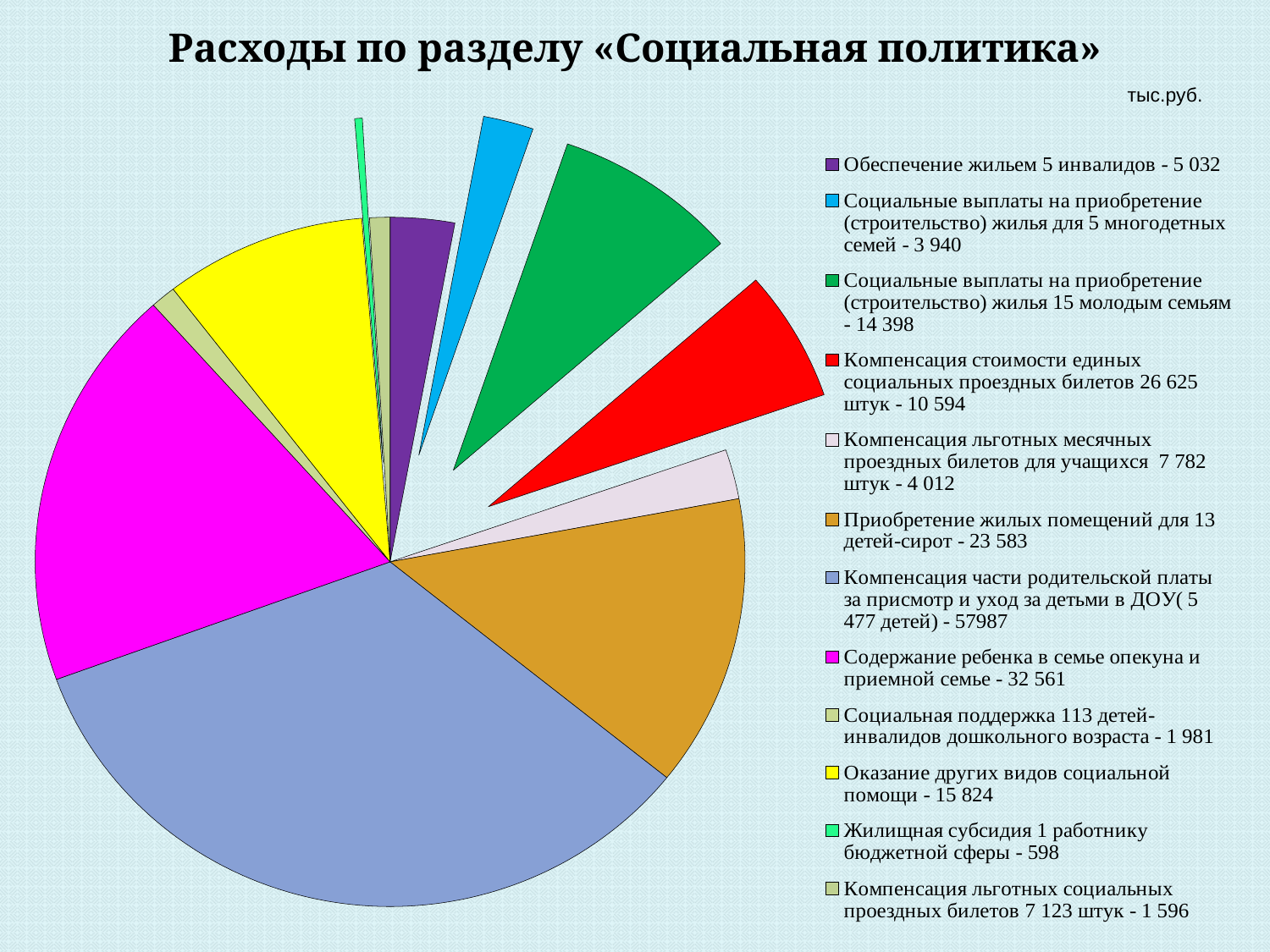
Which category has the smallest value? Жилищная субсидия 1 работнику бюджетной сферы What is the value for «Оказание других видов социальной помощи»? 15 824 What is the value for «Обеспечение жильем 5 инвалидов»? 5 032 Which is larger: «Социальные выплаты на приобретение (строительство) жилья 15 молодым семьям» or «Компенсация стоимости единых социальных проездных билетов 26 625 штук»? Социальные выплаты на приобретение (строительство) жилья 15 молодым семьям In what units are the values on the chart given? тыс.руб. How many categories does the pie chart have? 12 What is the value for «Приобретение жилых помещений для 13 детей-сирот»? 23 583 What is the difference between «Содержание ребенка в семье опекуна и приемной семье» and «Приобретение жилых помещений для 13 детей-сирот»? 8 978 Which category has the largest value? Компенсация части родительской платы за присмотр и уход за детьми в ДОУ (5 477 детей) What is the title of the chart? Расходы по разделу «Социальная политика» What type of chart is shown on the slide? Pie chart What is the value for «Компенсация льготных социальных проездных билетов 7 123 штук»? 1 596